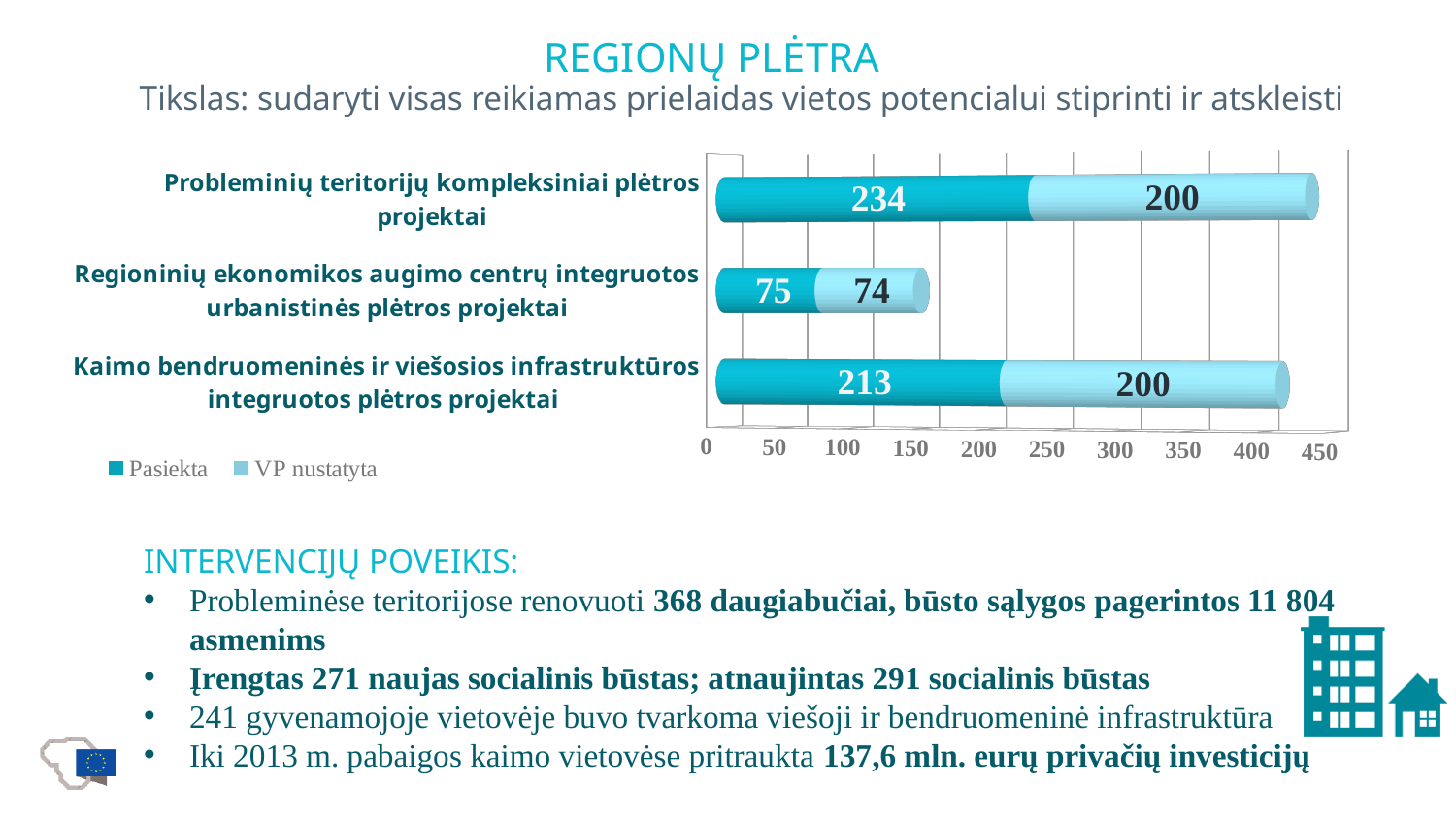
How many categories are shown in the chart? 3 Which category has the highest 'Pasiekta' value? Probleminių teritorijų kompleksiniai plėtros projektai What kind of chart is shown on the slide? Stacked bar chart Is the 'Pasiekta' value for 'Kaimo bendruomeninės ir viešosios infrastruktūros integruotos plėtros projektai' larger or smaller than its 'VP nustatyta' value? larger Which category has the lowest 'Pasiekta' value? Regioninių ekonomikos augimo centrų integruotos urbanistinės plėtros projektai What is the total of the stacked bar for 'Probleminių teritorijų kompleksiniai plėtros projektai'? 434 What is the 'VP nustatyta' value for 'Regioninių ekonomikos augimo centrų integruotos urbanistinės plėtros projektai'? 74 What is the 'Pasiekta' value for 'Kaimo bendruomeninės ir viešosios infrastruktūros integruotos plėtros projektai'? 213 How many series does the legend list? 2 What is the total of the stacked bar for 'Regioninių ekonomikos augimo centrų integruotos urbanistinės plėtros projektai'? 149 What is the difference between the 'Pasiekta' values for 'Probleminių teritorijų kompleksiniai plėtros projektai' and 'Kaimo bendruomeninės ir viešosios infrastruktūros integruotos plėtros projektai'? 21 What is the 'Pasiekta' value for 'Probleminių teritorijų kompleksiniai plėtros projektai'? 234